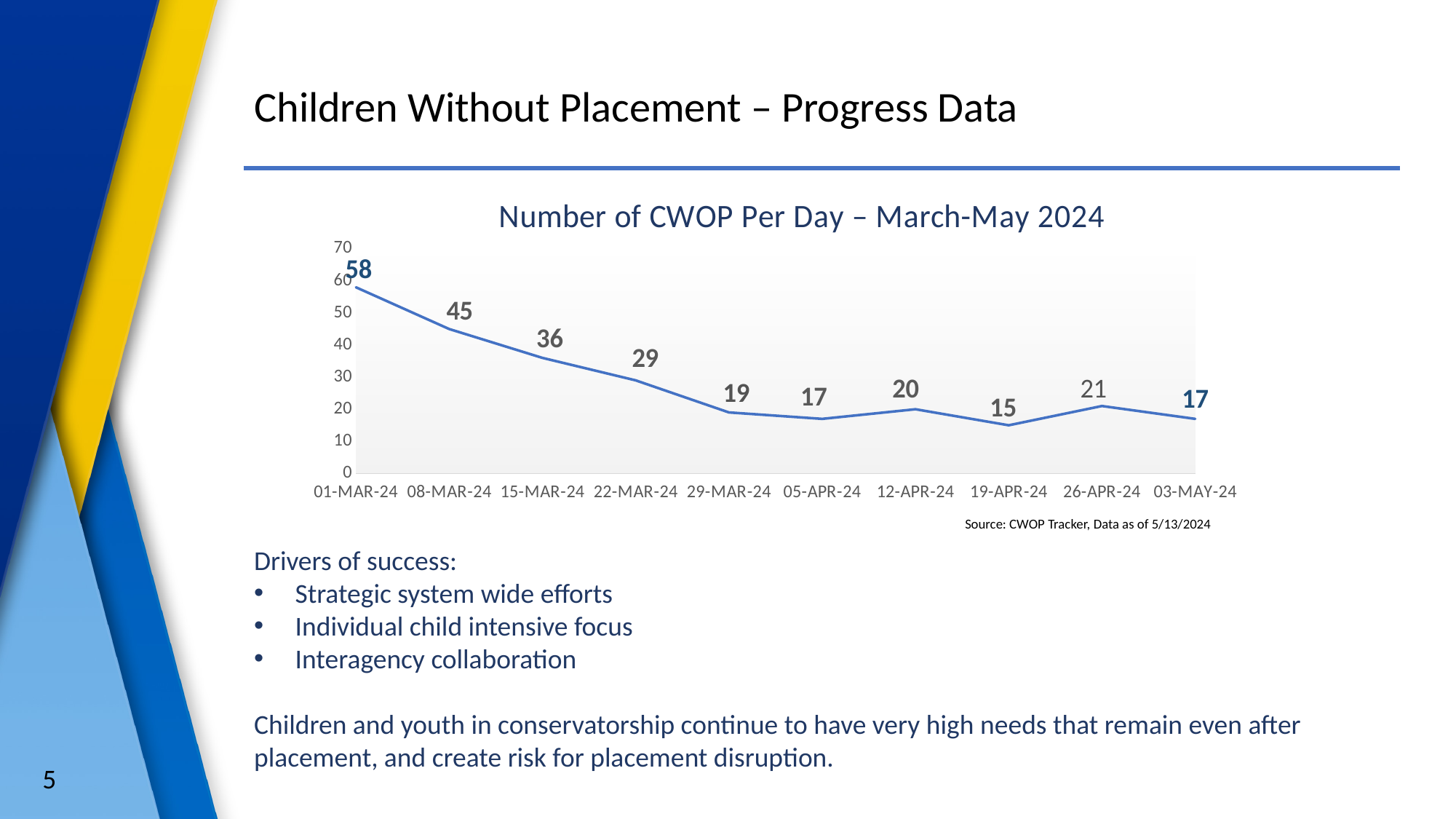
What is the difference between the number of CWOP on 08-MAR-24 and on 15-MAR-24? 9 Which is larger, the number of CWOP on 12-APR-24 or on 19-APR-24? 12-APR-24 What kind of chart is shown on the slide? Line chart What is the number of CWOP per day on 22-MAR-24? 29 What is the number of CWOP per day on 03-MAY-24? 17 Which date has the highest number of CWOP per day? 01-MAR-24 What is the difference between the number of CWOP on 01-MAR-24 and on 03-MAY-24? 41 How many dates are plotted on the x axis of the chart? 10 What is the number of CWOP per day on 01-MAR-24? 58 Do the values generally rise or fall from 01-MAR-24 to 29-MAR-24? Fall Which date has the lowest number of CWOP per day? 19-APR-24 What is the title of the chart? Number of CWOP Per Day – March-May 2024